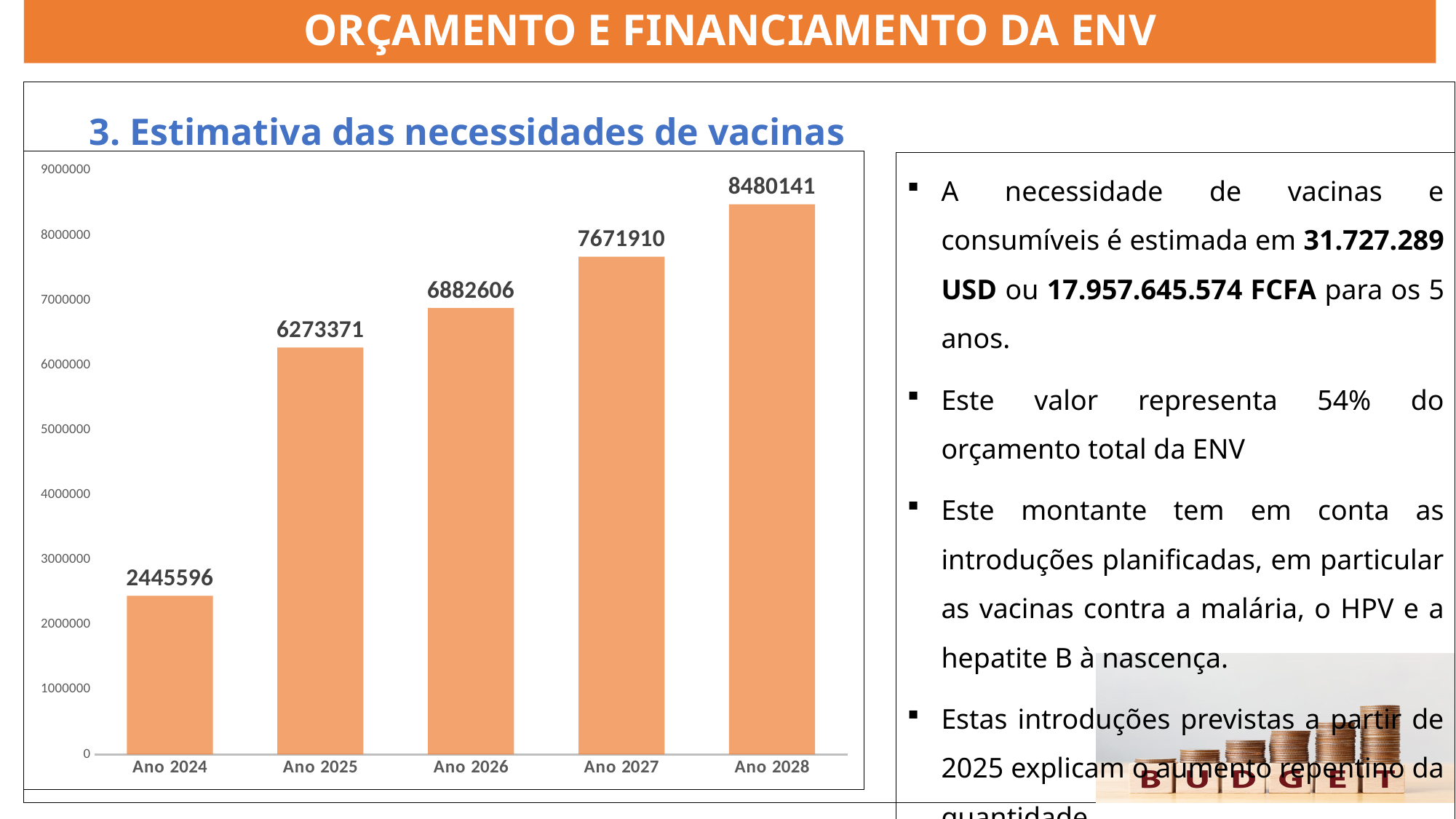
What kind of chart is shown on the slide? bar chart Is the value for Ano 2025 greater or less than 6000000? greater Which is larger, the value for Ano 2026 or the value for Ano 2027? Ano 2027 What is the value for Ano 2026? 6882606 How many years are shown on the x axis? 5 What is the difference between the values for Ano 2025 and Ano 2024? 3827775 Which year has the highest value? Ano 2028 Which year has the lowest value? Ano 2024 What is the value for Ano 2024? 2445596 Do the values rise or fall from Ano 2024 to Ano 2028? rise What is the value for Ano 2028? 8480141 What is the difference between the values for Ano 2028 and Ano 2027? 808231